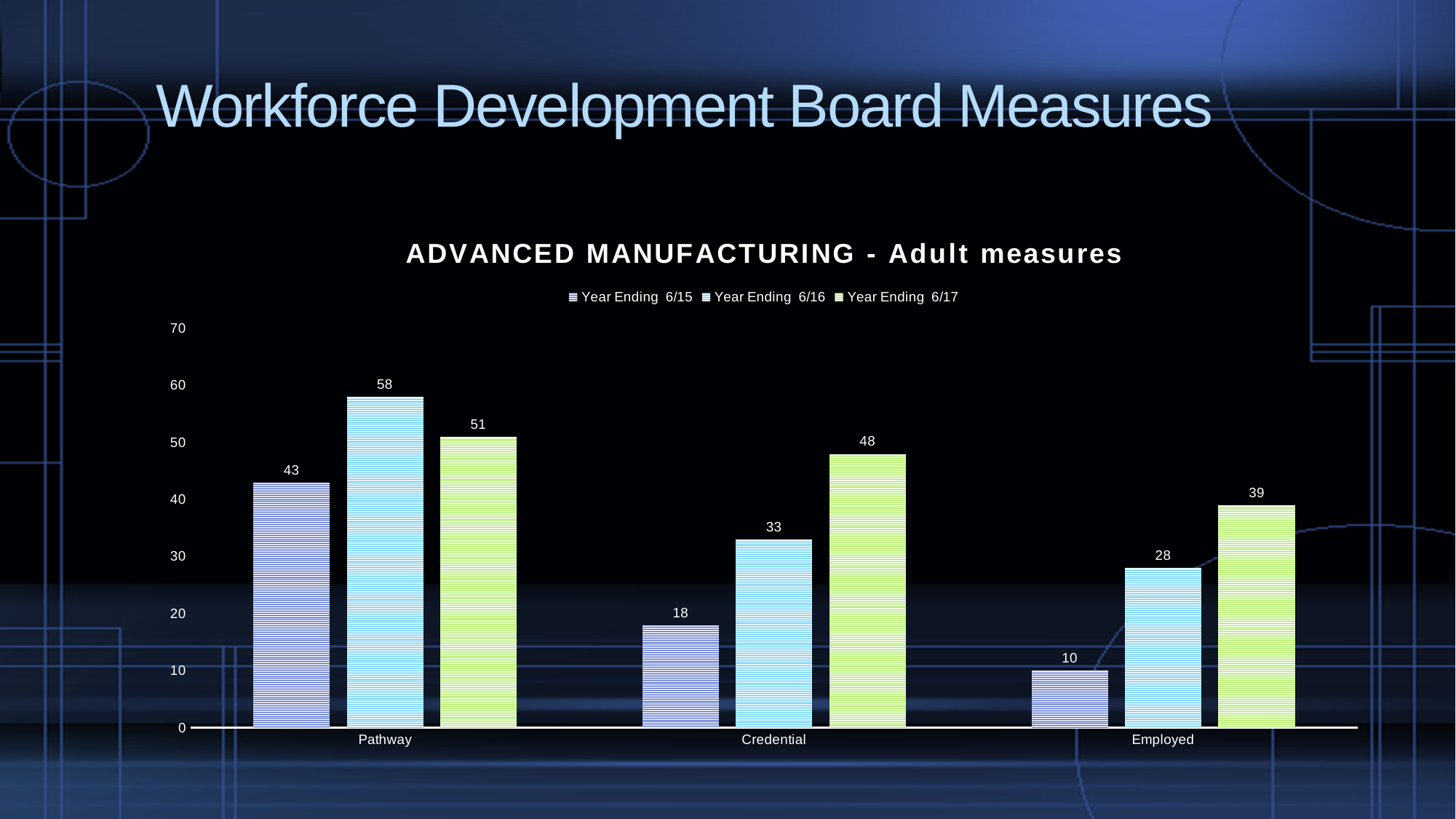
Which is larger for Pathway: the Year Ending 6/16 value or the Year Ending 6/17 value? Year Ending 6/16 What kind of chart is shown on the slide? bar chart How many series does the legend list? 3 How many categories are shown on the x axis? 3 Which category has the lowest value in the Year Ending 6/17 series? Employed What is the value for Employed in the Year Ending 6/15 series? 10 What is the difference between the Year Ending 6/16 and Year Ending 6/15 values for Credential? 15 What is the title of the chart? ADVANCED MANUFACTURING - Adult measures What is the value for Credential in the Year Ending 6/17 series? 48 Is the value for Employed in the Year Ending 6/17 series greater or less than 30? greater What is the value for Pathway in the Year Ending 6/16 series? 58 Which category has the highest value in the Year Ending 6/15 series? Pathway